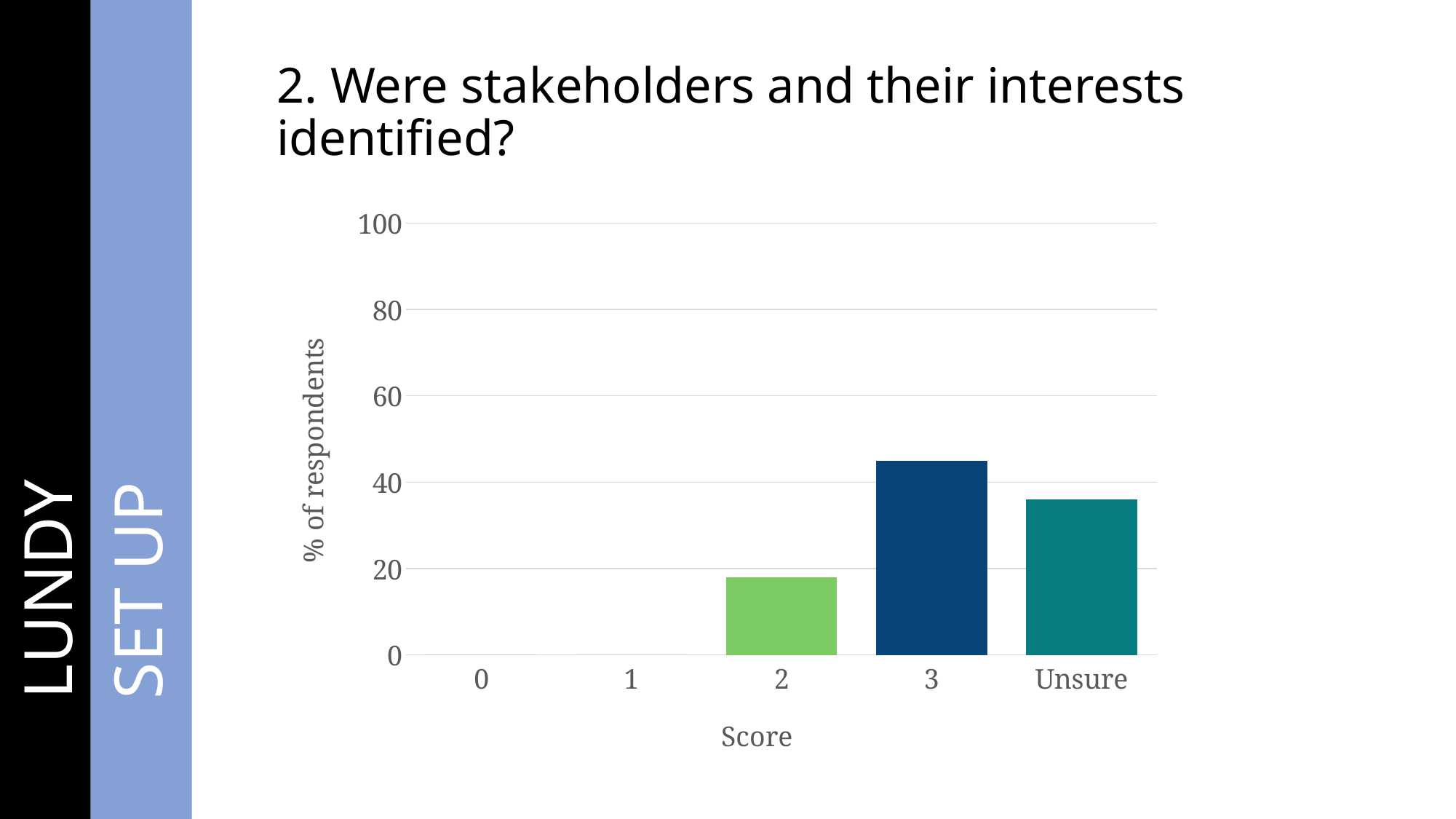
What is the label on the x axis? Score Is the value for score 3 greater or less than 40? greater Which is larger, the value for score 2 or the value for Unsure? Unsure Is the value for score 2 greater or less than 40? less Is the value for Unsure greater or less than 20? greater What kind of chart is shown on the slide? bar chart What is the label on the y axis? % of respondents Which is larger, the value for score 3 or the value for Unsure? 3 How many score categories are shown on the x axis? 5 Which score category has the highest percentage of respondents? 3